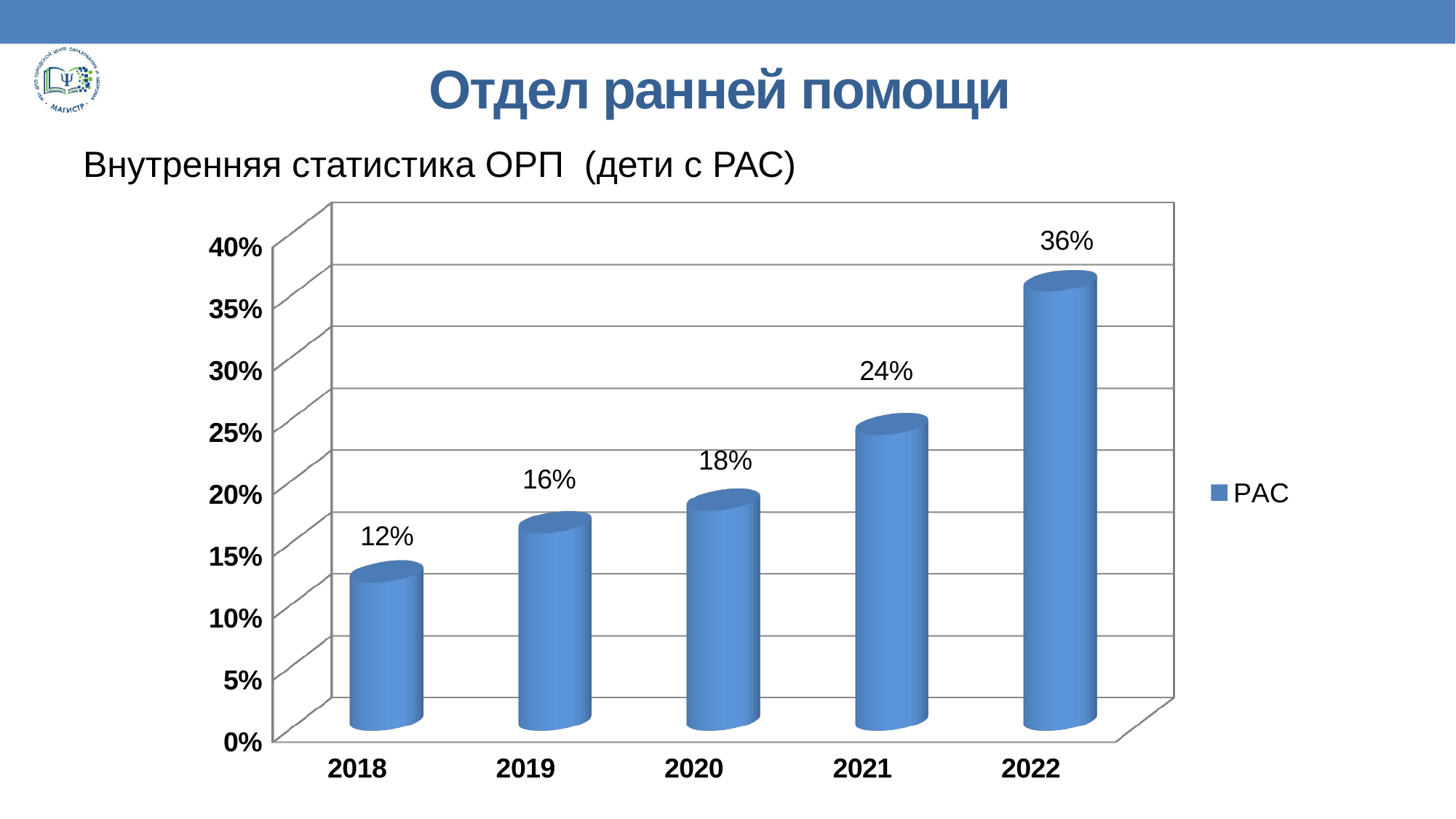
What is the difference between the values for 2022 and 2021? 12% How many series does the legend list? 1 Which is larger, the value for 2020 or the value for 2021? 2021 Which year has the lowest value? 2018 What is the value for 2022? 36% What is the value for 2020? 18% Do the values rise or fall from 2018 to 2022? rise Which year has the highest value? 2022 What is the difference between the values for 2019 and 2018? 4% How many years are shown on the x axis? 5 What kind of chart is shown? bar chart What is the value for 2018? 12%